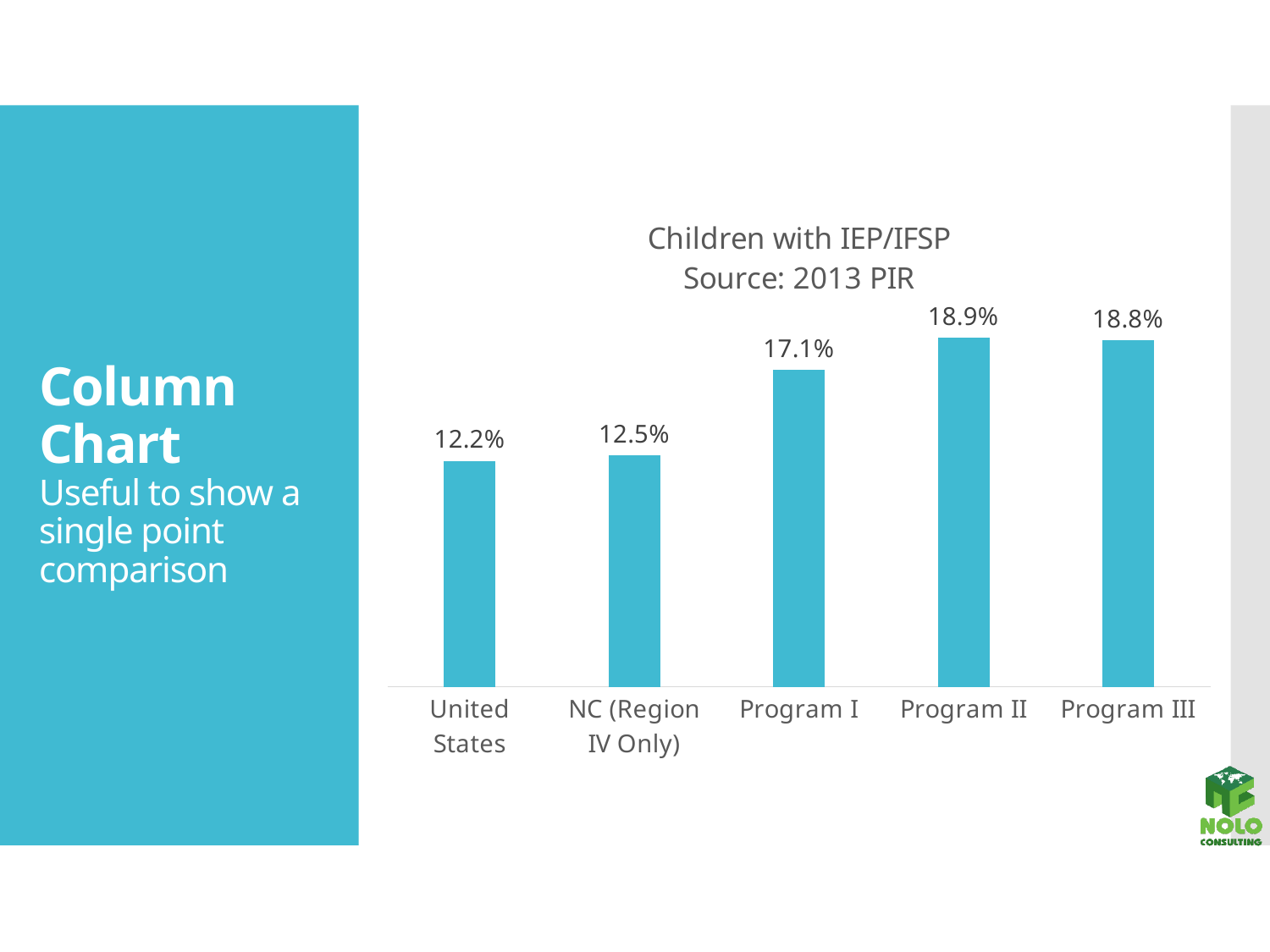
What is the title of the chart? Children with IEP/IFSP Source: 2013 PIR Which category has the lowest value in the chart? United States What kind of chart is shown on the slide? Bar chart What is the value for United States in the chart? 12.2% What is the value for Program III? 18.8% How many categories are shown in the chart? 5 What is the difference between the values for Program I and NC (Region IV Only)? 4.6 percentage points What is the difference between the values for Program II and United States? 6.7 percentage points What is the value for NC (Region IV Only)? 12.5% Which category has the highest value in the chart? Program II Which is larger, the value for Program I or the value for NC (Region IV Only)? Program I What is the value for Program I in the Children with IEP/IFSP chart? 17.1%